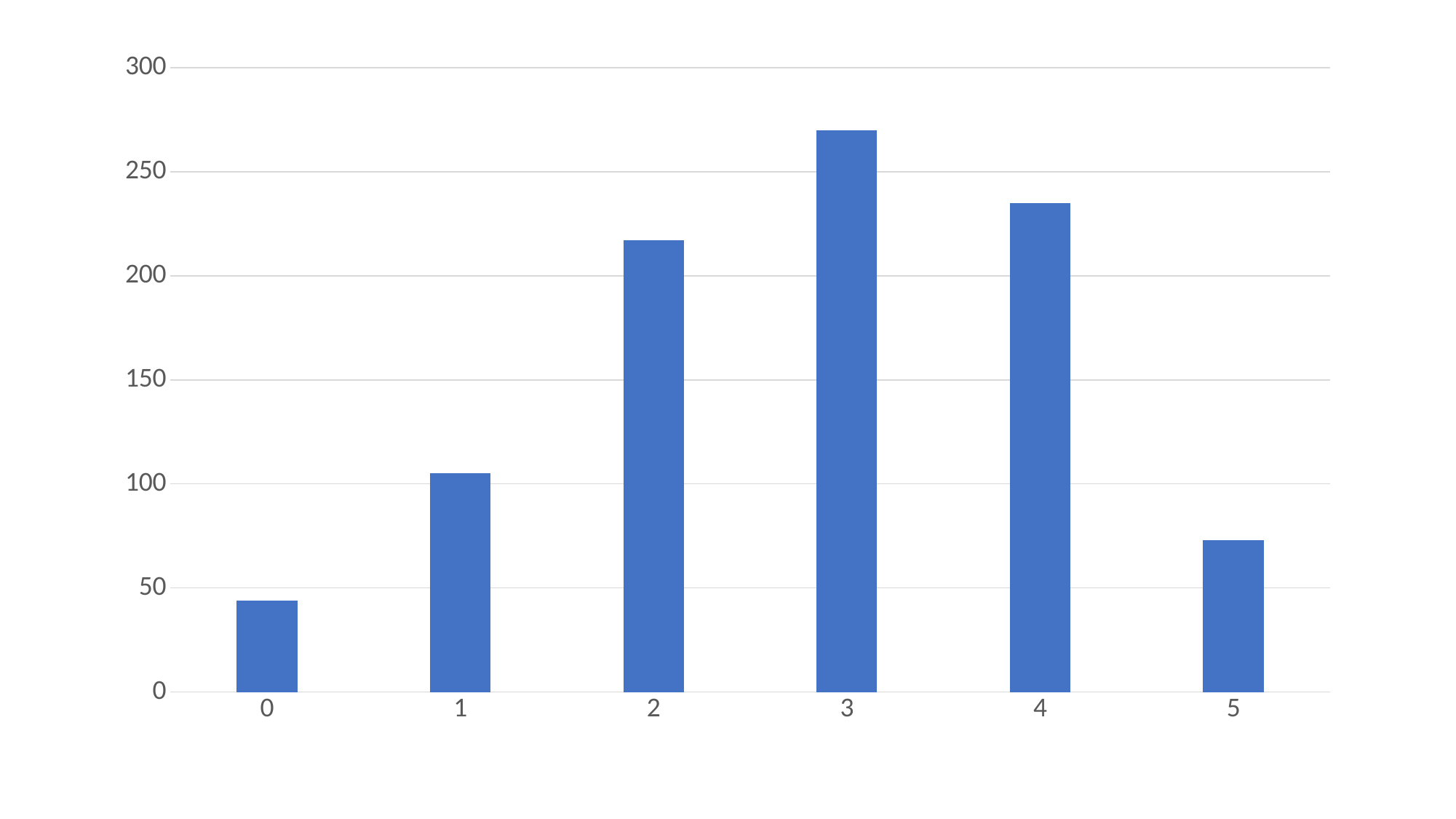
What is the highest value shown on the vertical axis? 300 Which is larger, the value for category 1 or the value for category 5? 1 Which is larger, the value for category 2 or the value for category 4? 4 Is the value for category 5 greater or less than 100? less Is the value for category 2 greater or less than 200? greater Is the value for category 0 greater or less than 50? less Do the values rise or fall from category 0 to category 3? rise Which category has the highest bar? 3 Which category has the lowest bar? 0 What kind of chart is shown on the slide? bar chart How many bars are plotted in the chart? 6